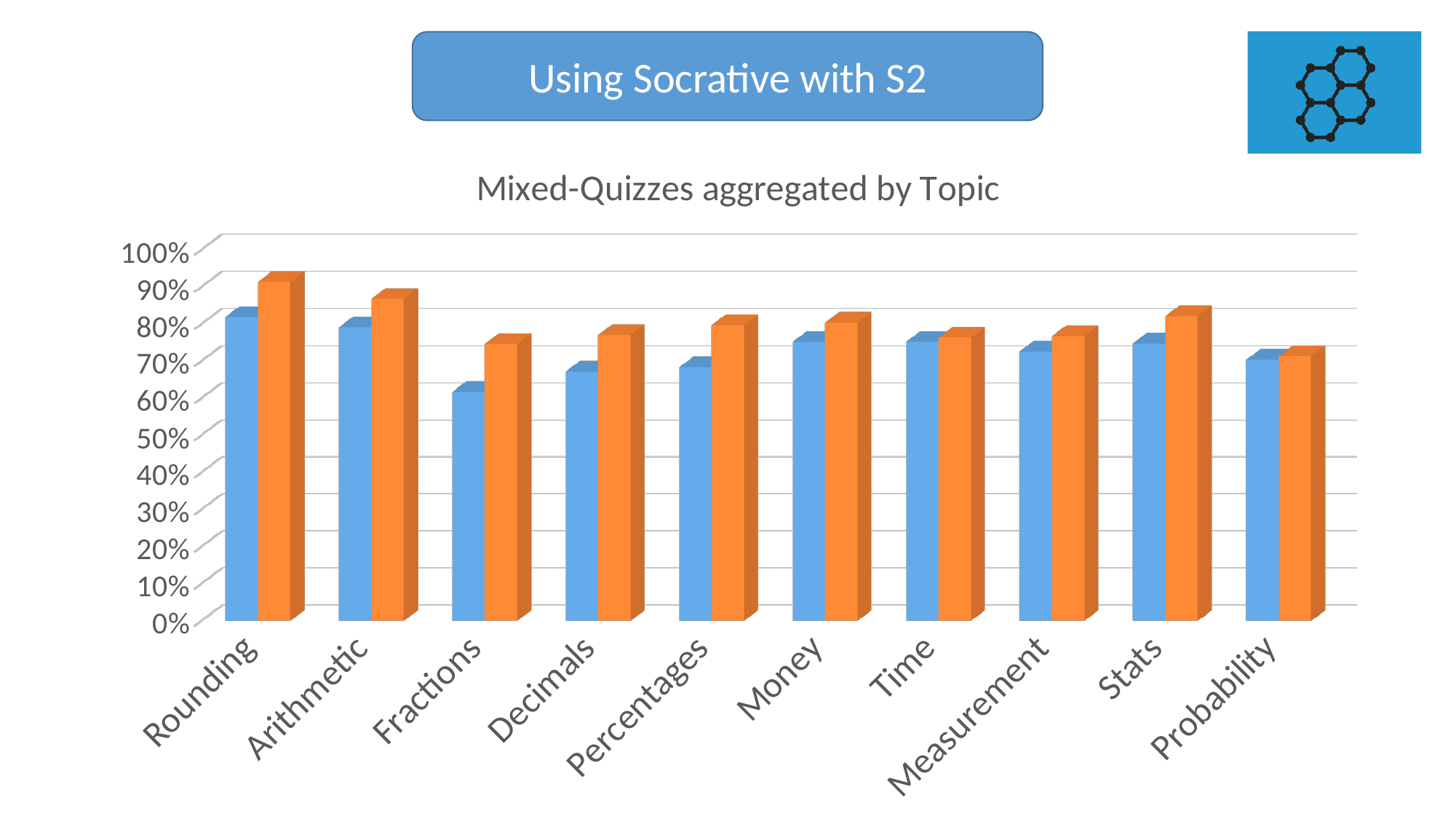
Is the orange bar for Rounding greater or less than 80%? greater Is the orange bar for Probability greater or less than 80%? less Which topic has the lowest blue bar? Fractions How many bars are plotted for each topic in the chart? 2 Which topic has the highest orange bar? Rounding What kind of chart is shown on the slide? bar chart What is the title of the chart? Mixed-Quizzes aggregated by Topic Is the blue bar for Rounding greater or less than 70%? greater Which is larger, the orange bar for Arithmetic or the orange bar for Decimals? Arithmetic Which is larger, the blue bar for Rounding or the blue bar for Fractions? Rounding How many topics are shown along the x axis of the chart? 10